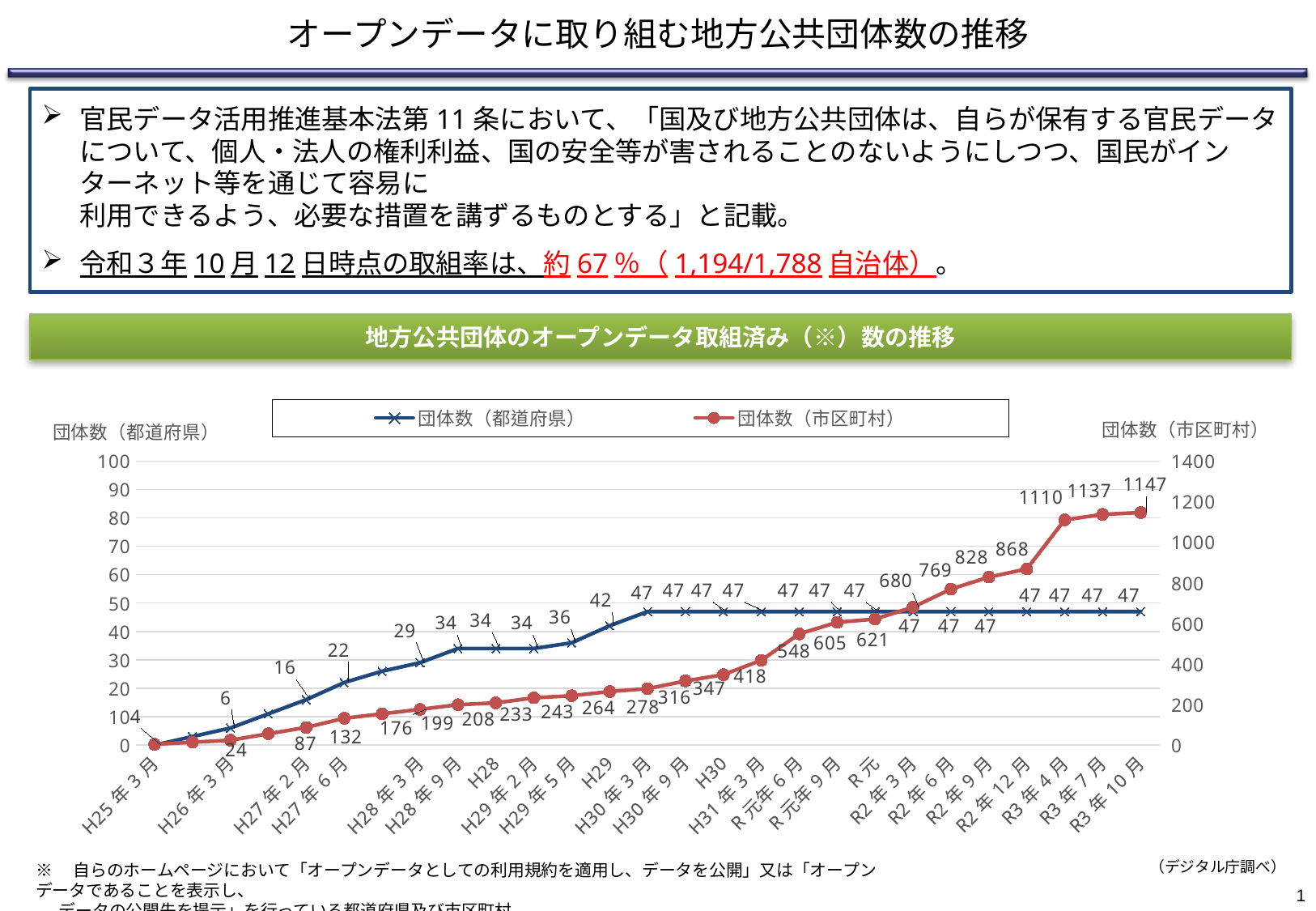
How many series does the legend list? 2 What is the value of 団体数（市区町村） at R3年10月? 1147 What is the value of 団体数（市区町村） at H31年3月? 418 What kind of chart is shown on the slide? line chart What is the value of 団体数（都道府県） at R3年10月? 47 At which time point is 団体数（市区町村） lowest? H25年3月 Do the 団体数（市区町村） values rise or fall along the x axis? rise What is the difference between the 団体数（市区町村） values at R3年4月 and R2年12月? 242 What is the difference between the 団体数（市区町村） values at R3年10月 and R3年7月? 10 At which time point is 団体数（市区町村） highest? R3年10月 Which is larger for 団体数（市区町村）: the value at H31年3月 or at R元年6月? R元年6月 What is the value of 団体数（市区町村） at R2年3月? 680